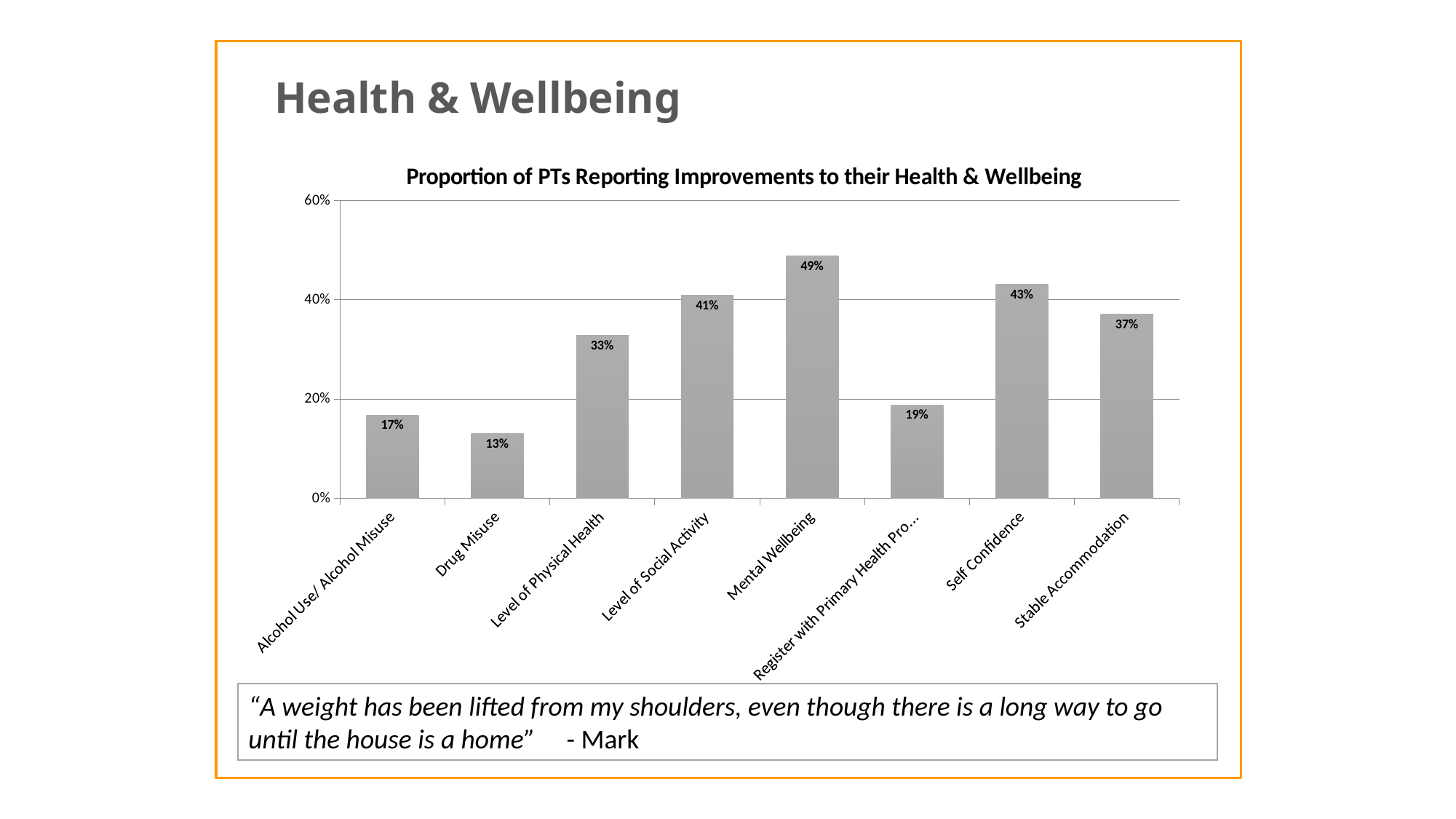
What is the value for Self Confidence? 43% How many categories are shown in the chart? 8 What is the value for Stable Accommodation? 37% What is the value for Drug Misuse? 13% Which category has the highest value? Mental Wellbeing Which category has the lowest value? Drug Misuse What is the difference between the values for Level of Social Activity and Level of Physical Health? 8% What kind of chart is shown on the slide? Bar chart What is the value for Mental Wellbeing? 49% Which is larger, the value for Alcohol Use/ Alcohol Misuse or the value for Drug Misuse? Alcohol Use/ Alcohol Misuse What is the difference between the values for Mental Wellbeing and Self Confidence? 6% What is the title of the chart? Proportion of PTs Reporting Improvements to their Health & Wellbeing